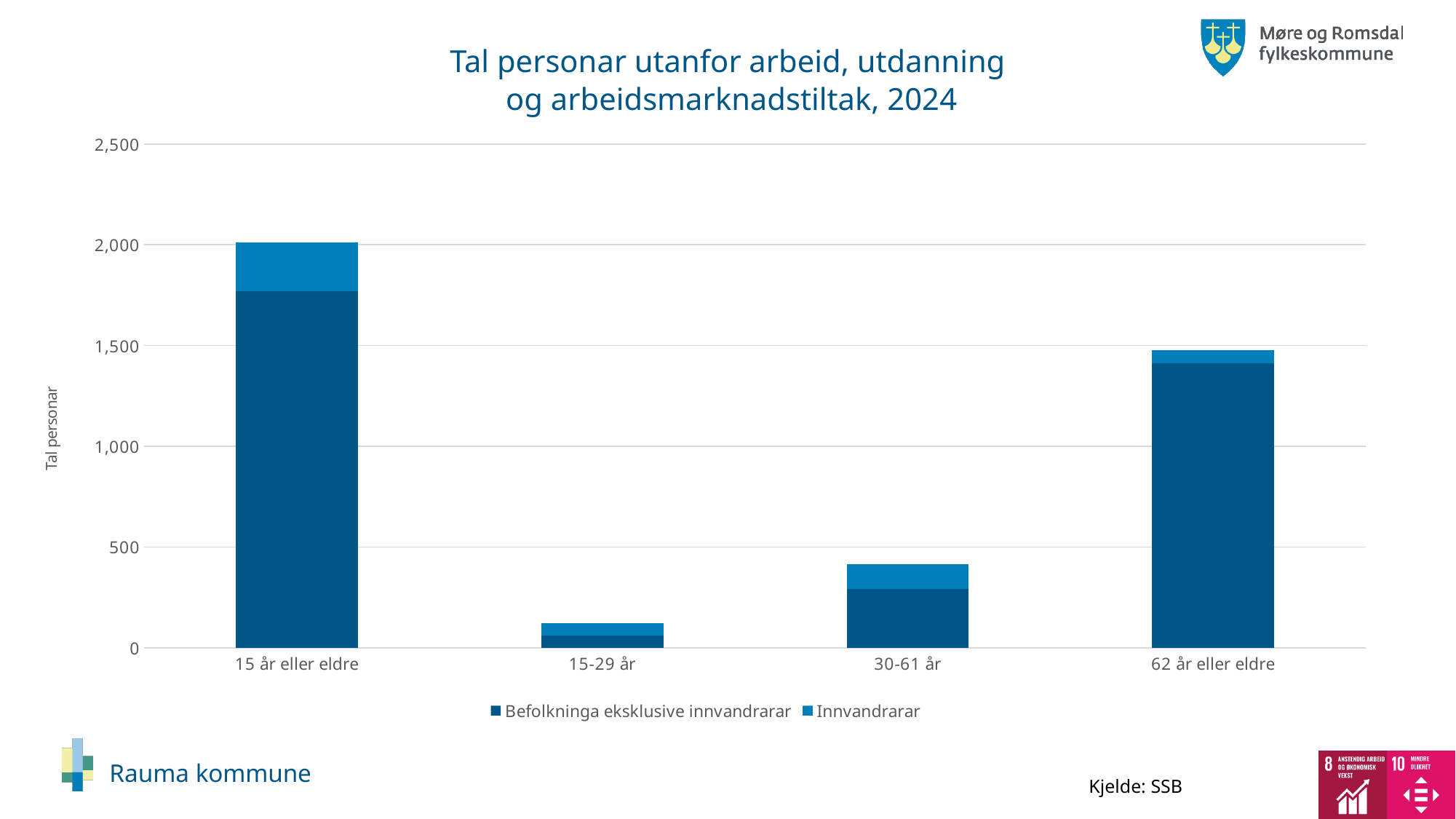
How many series does the legend list? 2 Which stacked bar is taller, 30-61 år or 62 år eller eldre? 62 år eller eldre What is the label of the y axis? Tal personar Which age category has the shortest stacked bar? 15-29 år What source is cited for the chart data? SSB Is the total value for 30-61 år greater or less than 500? less What kind of chart is shown on the slide? Stacked bar chart Which age category has the tallest stacked bar? 15 år eller eldre Is the total value for 62 år eller eldre greater or less than 1,500? less How many age categories are shown on the x axis? 4 Is the total value for 15-29 år greater or less than 500? less